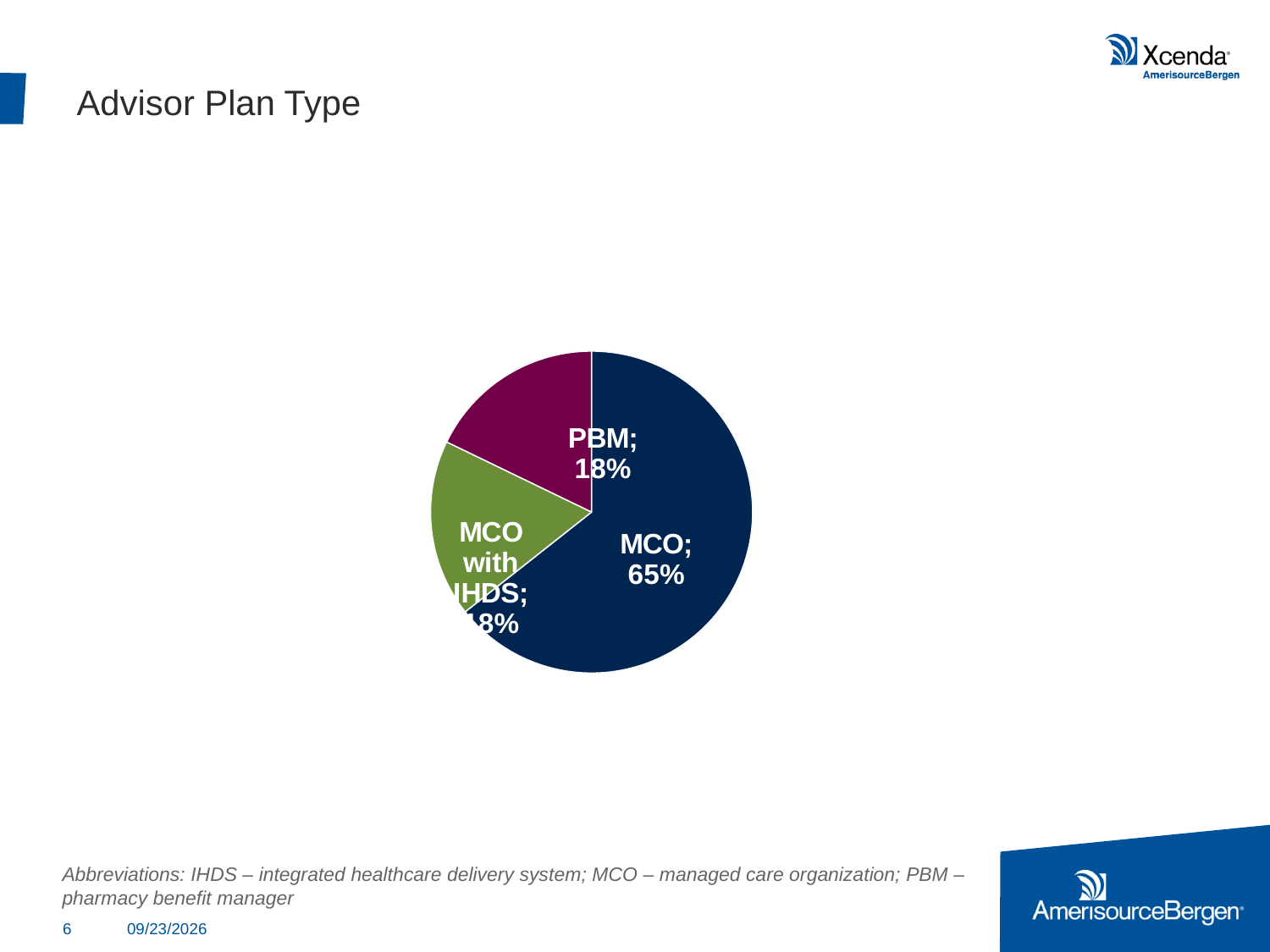
What percentage of advisors are in the PBM plan type? 18% What type of chart is shown on the slide? pie chart What is the title of the slide containing the pie chart? Advisor Plan Type What percentage of advisors are in the MCO plan type? 65% How many plan types (slices) are shown in the pie chart? 3 Which plan type has the largest share of the pie? MCO What is the difference between the MCO share and the PBM share? 47% What share of the pie does the MCO slice represent? 65% Which is larger, the share for MCO or the share for PBM? MCO What colour is the MCO slice of the pie chart? dark blue Which is larger, the share for MCO or the share for MCO with IHDS? MCO